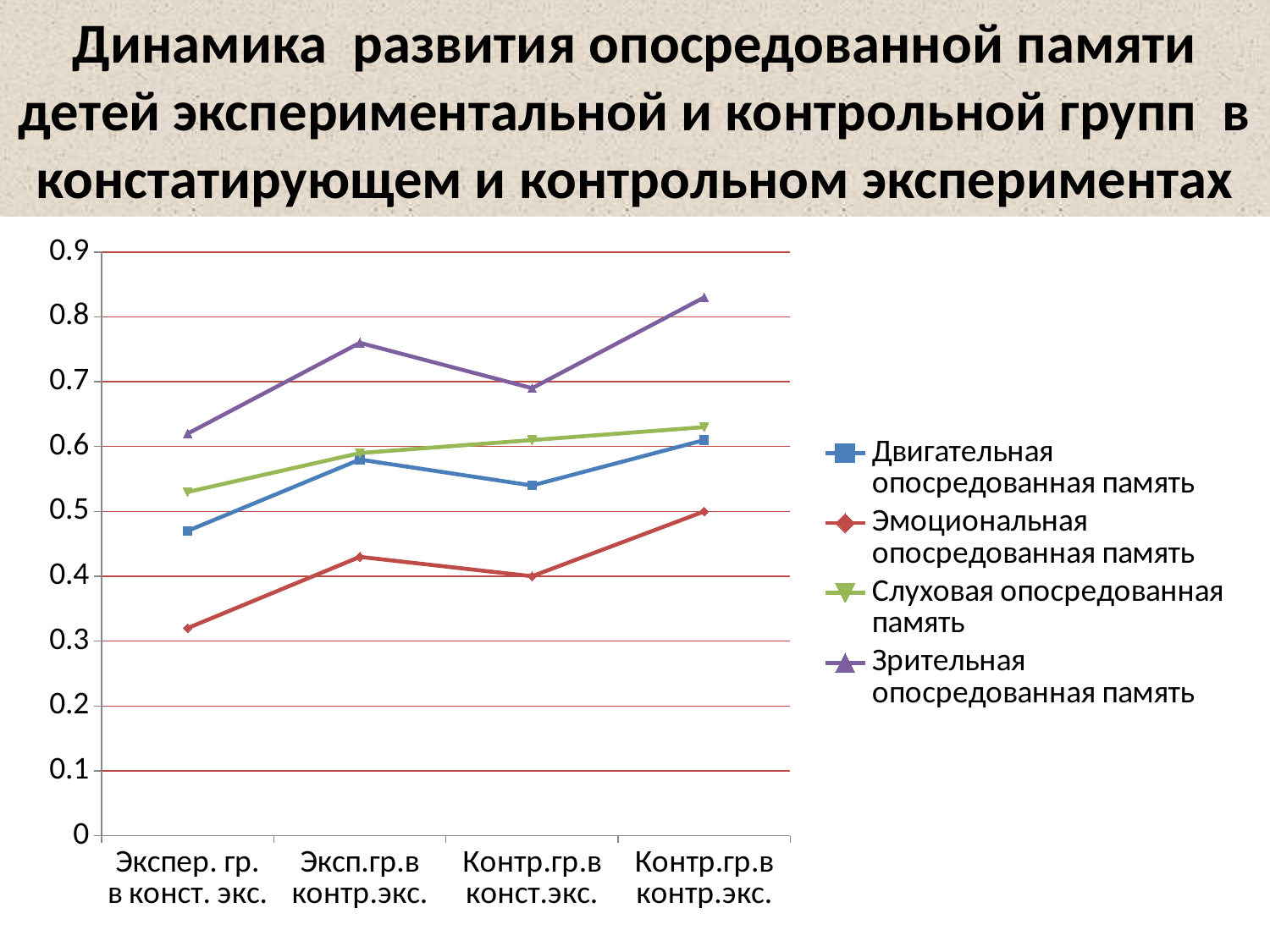
Which series has the lowest value at Экспер. гр. в конст. экс.? Эмоциональная опосредованная память Is the value for Эмоциональная опосредованная память at Экспер. гр. в конст. экс. greater or less than 0.4? less Is the value for Двигательная опосредованная память at Экспер. гр. в конст. экс. greater or less than 0.5? less For Зрительная опосредованная память, which category has the highest value? Контр.гр.в контр.экс. For Эмоциональная опосредованная память, which category has the lowest value? Экспер. гр. в конст. экс. At Экспер. гр. в конст. экс., which is larger: Зрительная опосредованная память or Эмоциональная опосредованная память? Зрительная опосредованная память Do the values for Слуховая опосредованная память rise or fall from left to right along the x axis? rise How many series does the legend list? 4 Is the value for Зрительная опосредованная память at Контр.гр.в контр.экс. greater or less than 0.8? greater What kind of chart is shown on the slide? line chart Which series has the highest value at Контр.гр.в контр.экс.? Зрительная опосредованная память How many categories are shown along the x axis? 4